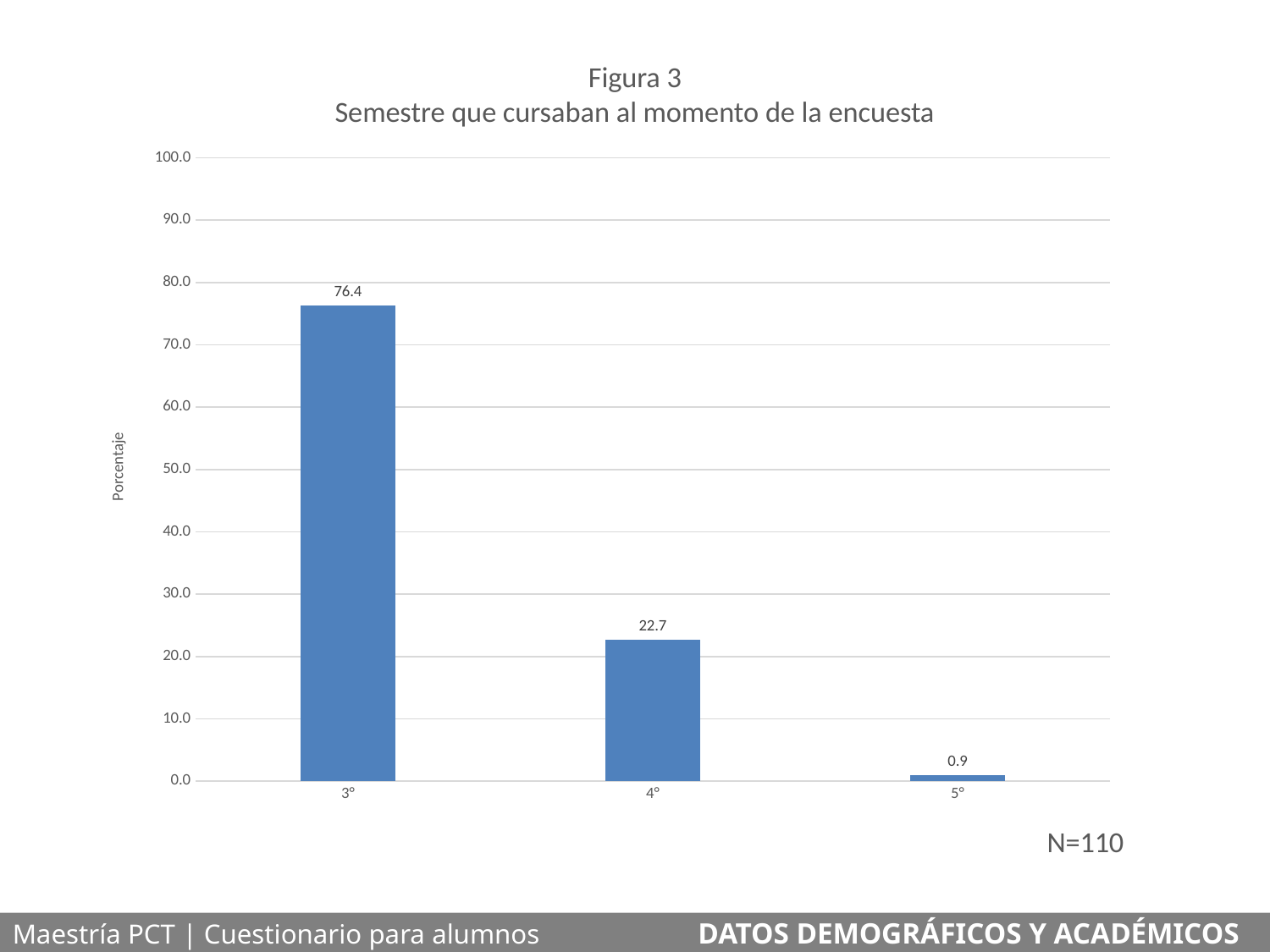
What is the value for 3°? 76.4 Which semester has the lowest percentage? 5° What kind of chart is shown? bar chart Which is larger, the value for 4° or the value for 5°? 4° What is the label of the y axis? Porcentaje What is the value for 5°? 0.9 What is the difference between the values for 3° and 4°? 53.7 What is the value for 4°? 22.7 Which semester has the highest percentage? 3° Is the value for 3° greater or less than 70.0? greater What is the difference between the values for 4° and 5°? 21.8 How many categories are shown on the x axis? 3